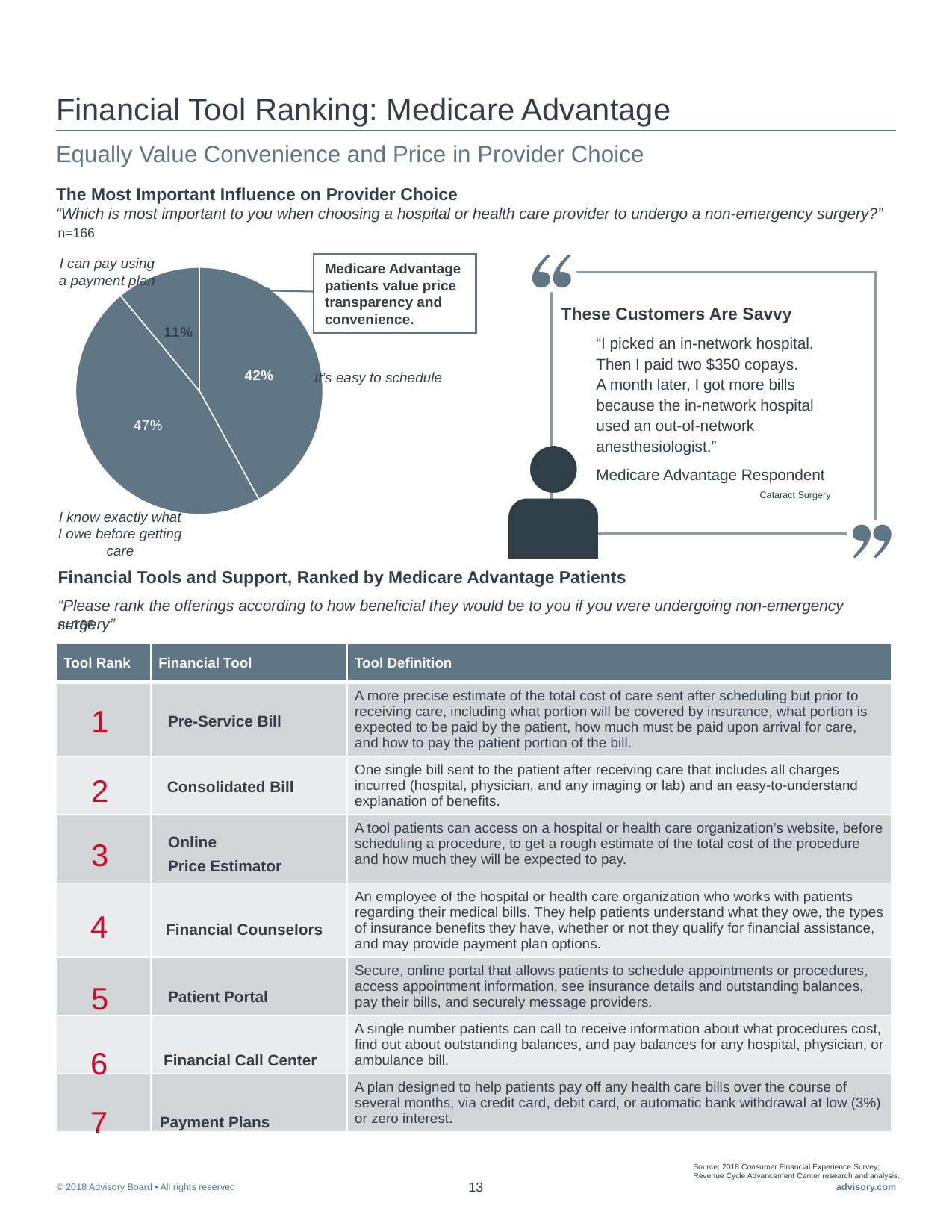
In the pie chart, what share of respondents chose "It's easy to schedule"? 42% Which slice of the pie chart is the smallest? I can pay using a payment plan In the pie chart, what share of respondents chose "I know exactly what I owe before getting care"? 47% Which slice of the pie chart is the largest? I know exactly what I owe before getting care How many slices does the pie chart have? 3 What is the difference in percentage points between "I know exactly what I owe before getting care" and "It's easy to schedule" in the pie chart? 5 percentage points What is the difference in percentage points between "It's easy to schedule" and "I can pay using a payment plan" in the pie chart? 31 percentage points What kind of chart is shown under "The Most Important Influence on Provider Choice"? Pie chart In the pie chart, what share of respondents chose "I can pay using a payment plan"? 11% What is the title of the pie chart? The Most Important Influence on Provider Choice What is the sample size (n) stated for the pie chart? n=166 In the pie chart, which is larger: "It's easy to schedule" or "I can pay using a payment plan"? It's easy to schedule